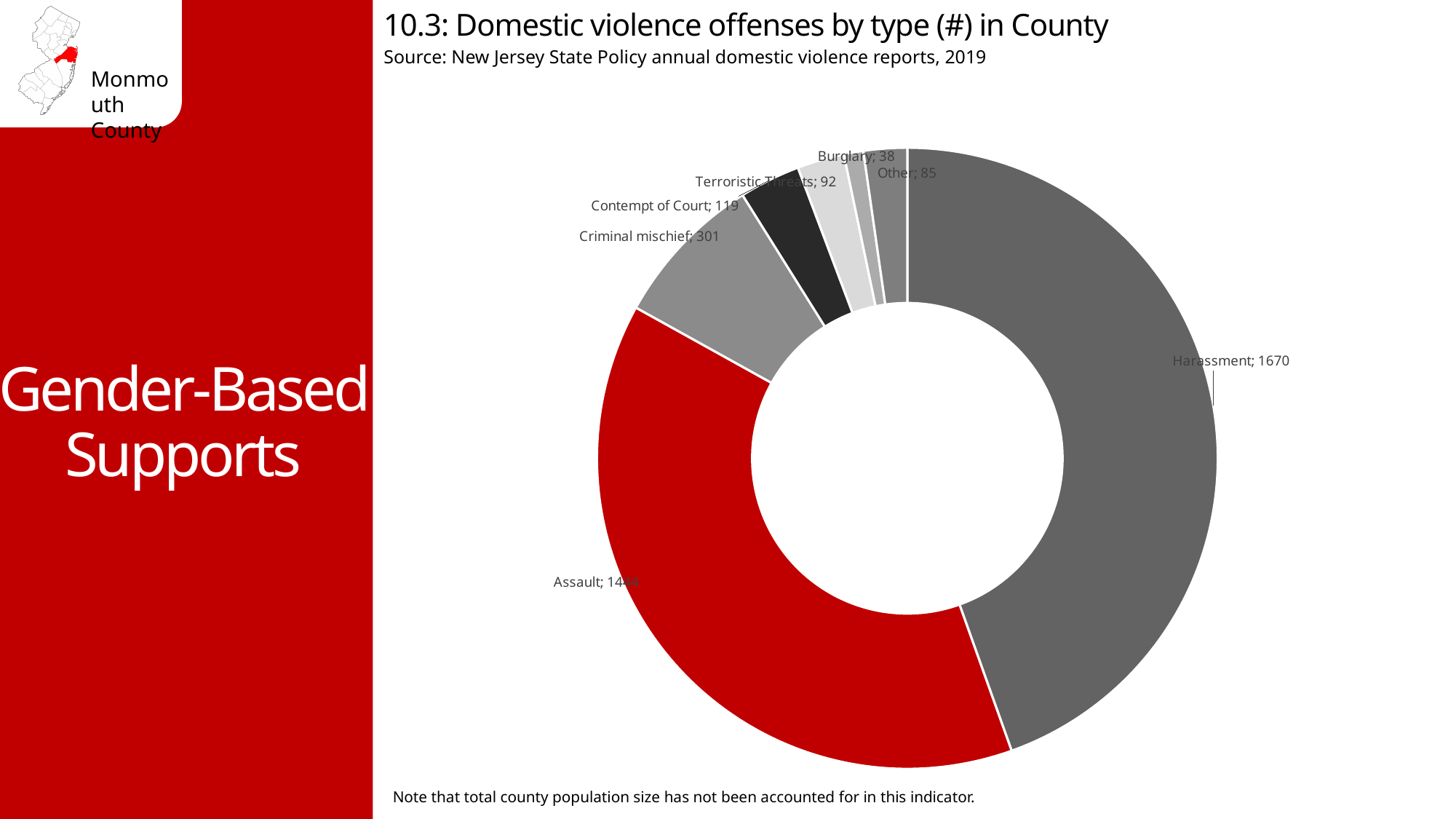
How many offense types (slices) are shown in the chart? 7 Which offense type has the highest number of offenses? Harassment What is the difference between the number of Other offenses and Burglary offenses? 47 What is the number of Contempt of Court offenses shown in the chart? 119 Which has more offenses, Criminal mischief or Contempt of Court? Criminal mischief Which slice of the chart is coloured red? Assault Which offense type has the lowest number of offenses? Burglary What is the number of Terroristic Threats offenses shown in the chart? 92 What is the number of Harassment offenses shown in the chart? 1670 What type of chart is shown on the slide? Doughnut (pie) chart What is the number of Burglary offenses shown in the chart? 38 What is the number of Criminal mischief offenses shown in the chart? 301